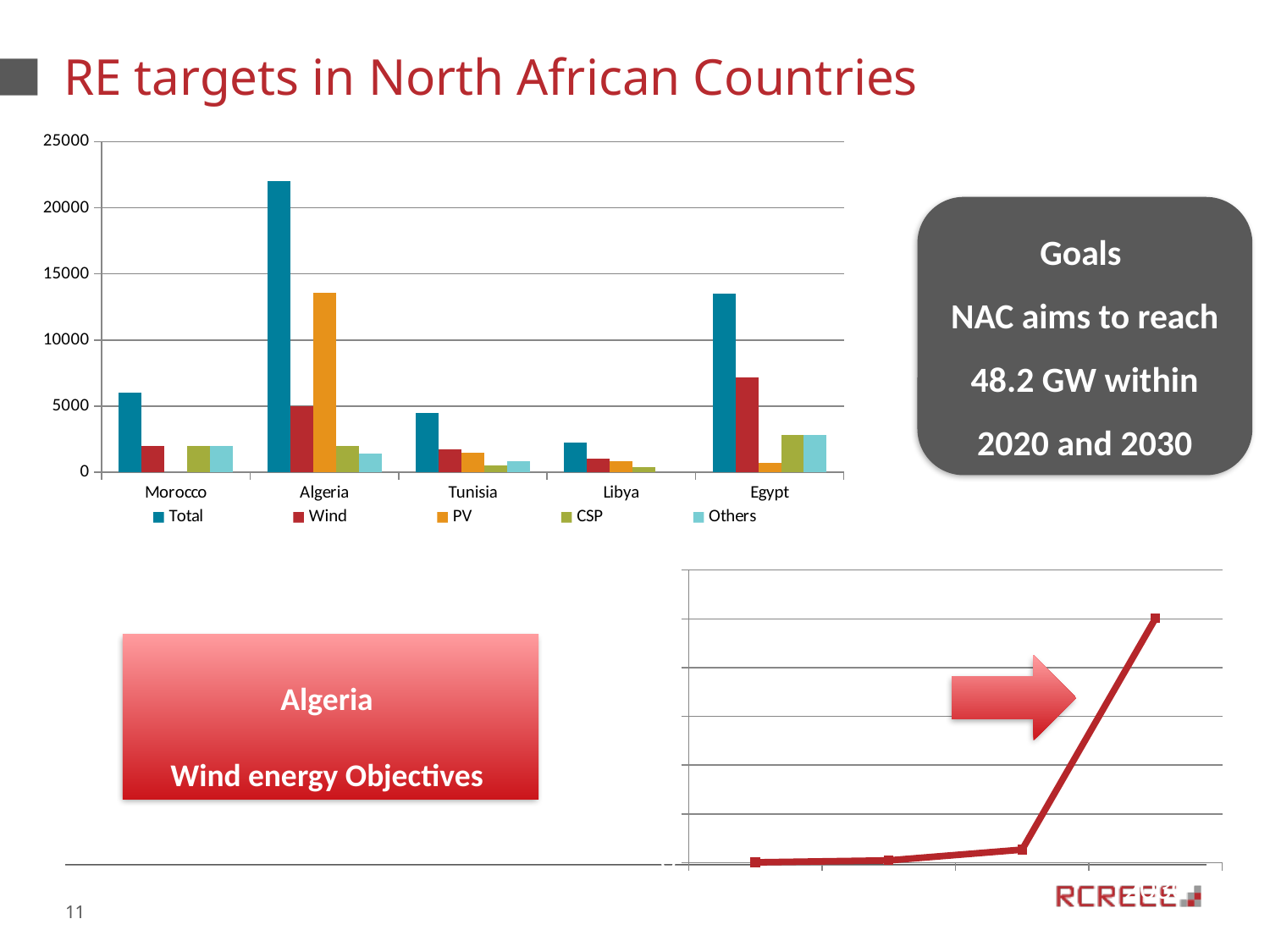
In the top chart, which is larger: the Wind value for Egypt or the Wind value for Algeria? Egypt In the top chart, what are the series names listed in the legend? Total, Wind, PV, CSP, Others In the top chart, which country has the highest PV value? Algeria In the top chart, is the Total value for Egypt greater or less than 15000? less In the top chart, how many series does the legend list? 5 In the top chart, what kind of chart is used to show the RE targets? bar chart In the top chart, is the PV value for Algeria greater or less than 10000? greater In the top chart, which country has the lowest Total value? Libya In the top chart, which country has the highest Total value? Algeria In the top chart, is the Total value for Tunisia greater or less than 5000? less In the top chart, how many countries are shown on the x axis? 5